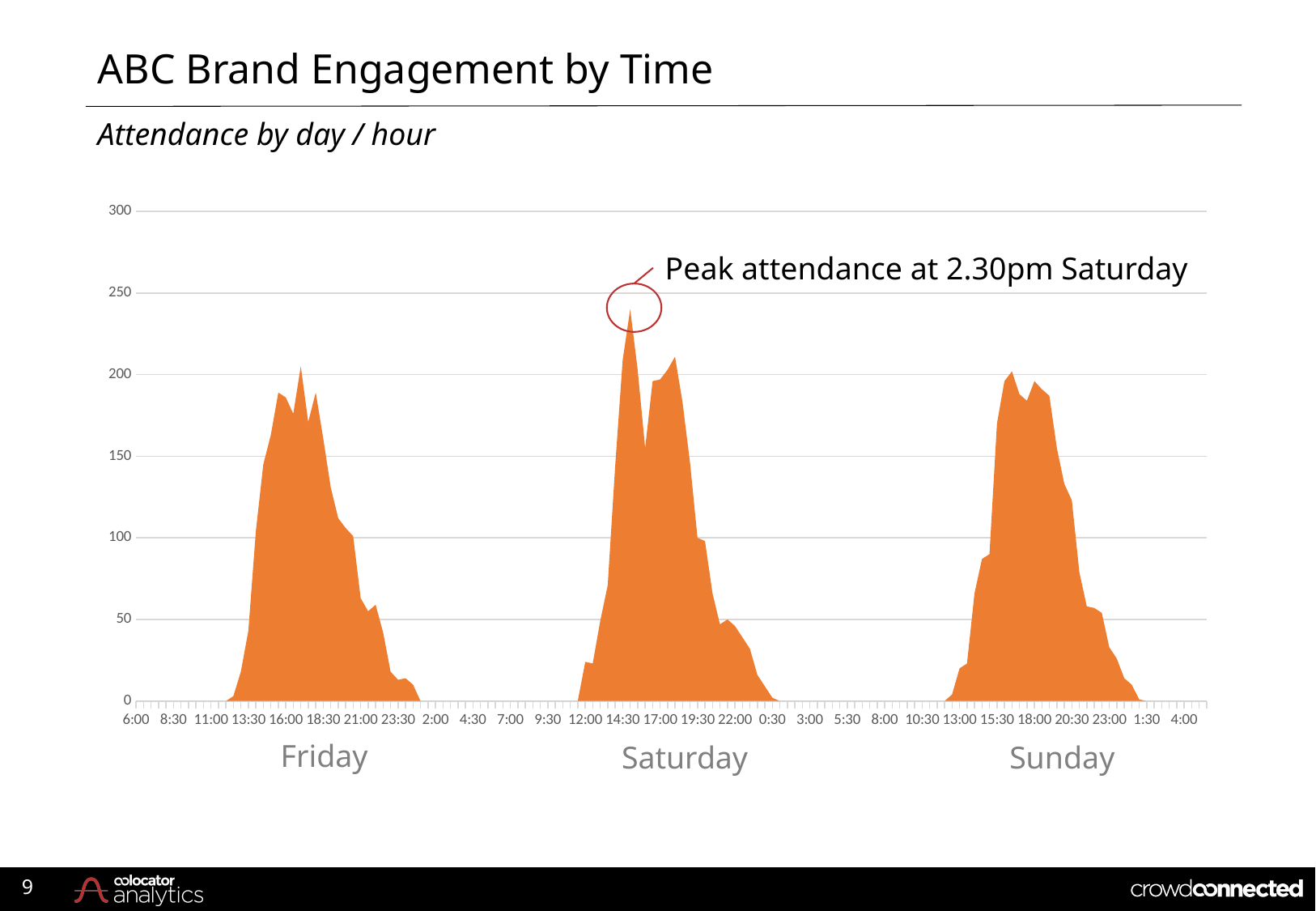
What is the highest value shown on the y axis? 300 Which is larger, the peak attendance on Friday or on Saturday? Saturday Is the peak attendance on Friday greater or less than 250? less Within each day, does attendance rise and then fall, or fall and then rise, as time progresses? Rises and then falls Is the peak attendance on Saturday greater or less than 200? greater Is the peak attendance on Sunday greater or less than 150? greater According to the annotation, when does peak attendance occur? 2.30pm Saturday Which day has the highest peak attendance? Saturday What kind of chart is shown on the slide? Area chart How many days are shown along the x axis of the chart? 3